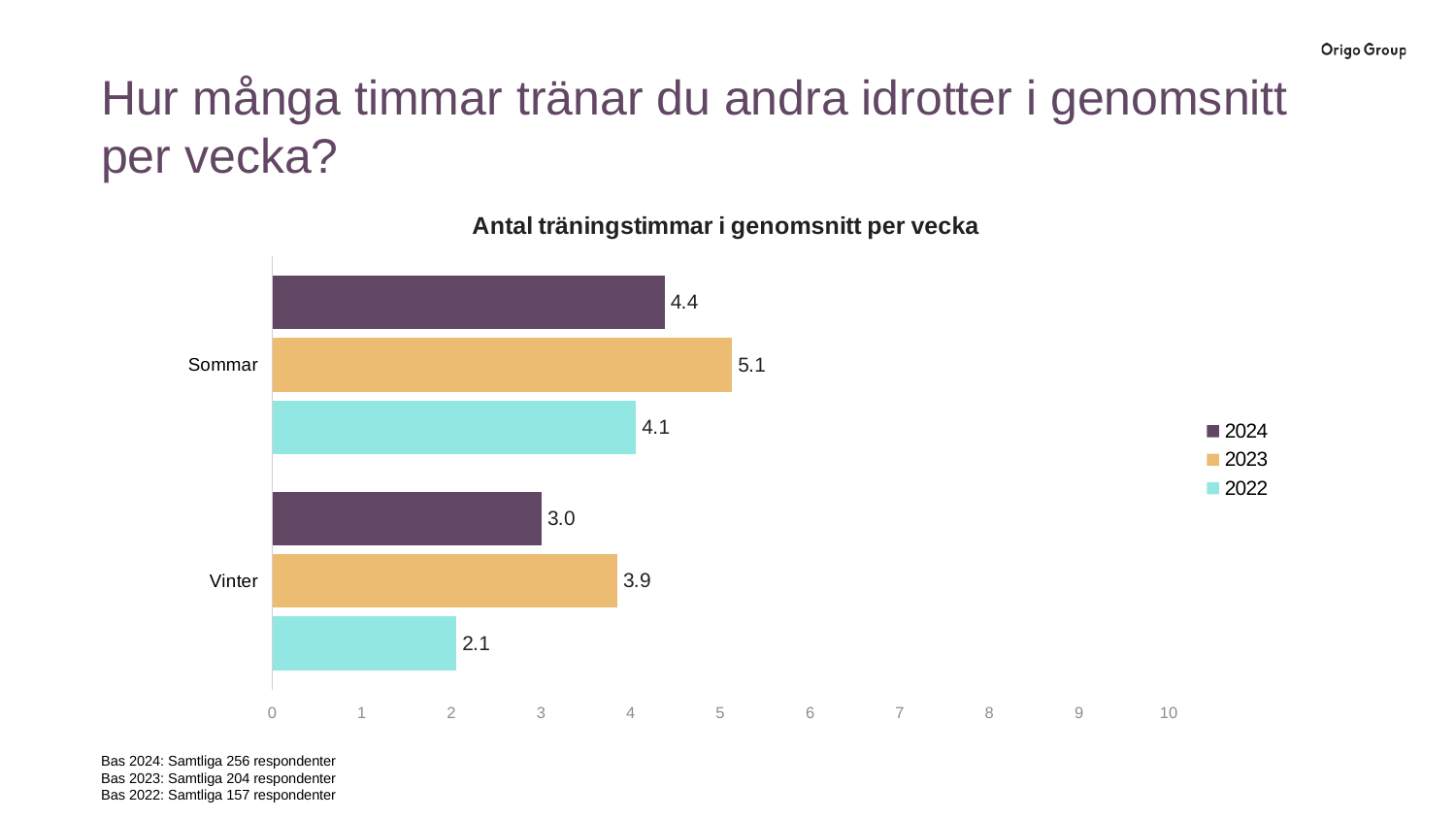
How many series does the legend list? 3 How many categories are shown on the chart? 2 Which is larger: the 2024 value for Sommar or the 2023 value for Vinter? 2024 value for Sommar What is the difference between the 2023 and 2022 values for Sommar? 1.0 What is the value for 2023 in the Sommar category? 5.1 Which year has the highest value in the Sommar category? 2023 Is the 2023 value for Sommar greater or less than 5? greater What is the value for 2022 in the Vinter category? 2.1 What kind of chart is shown on the slide? Bar chart Which year has the lowest value in the Vinter category? 2022 What is the value for 2024 in the Vinter category? 3.0 What is the difference between the 2024 values for Sommar and Vinter? 1.4